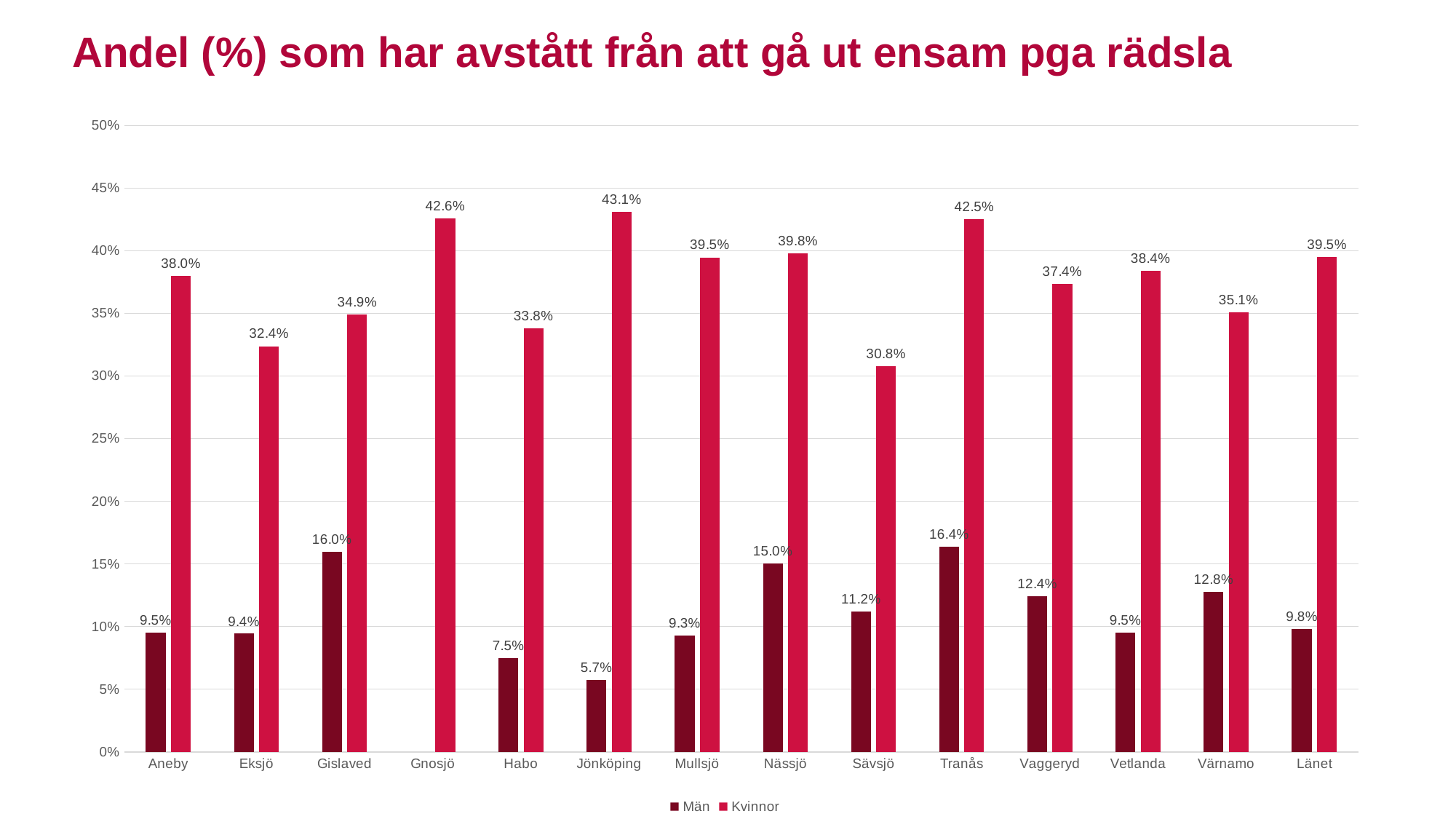
Which category has the lowest value for Kvinnor? Sävsjö Which category has the highest value for Kvinnor? Jönköping Which is larger, the Män value for Nässjö or the Män value for Vaggeryd? Nässjö What is the difference between the Kvinnor and Män values in Jönköping? 37.4 percentage points What is the value for Män in Gislaved? 16.0% What kind of chart is shown on the slide? Bar chart What is the value for Kvinnor in Länet? 39.5% What is the value for Kvinnor in Jönköping? 43.1% How many series does the legend list? 2 Which category has the lowest value for Män? Jönköping What are the two series named in the legend? Män and Kvinnor How many categories are shown on the x axis? 14